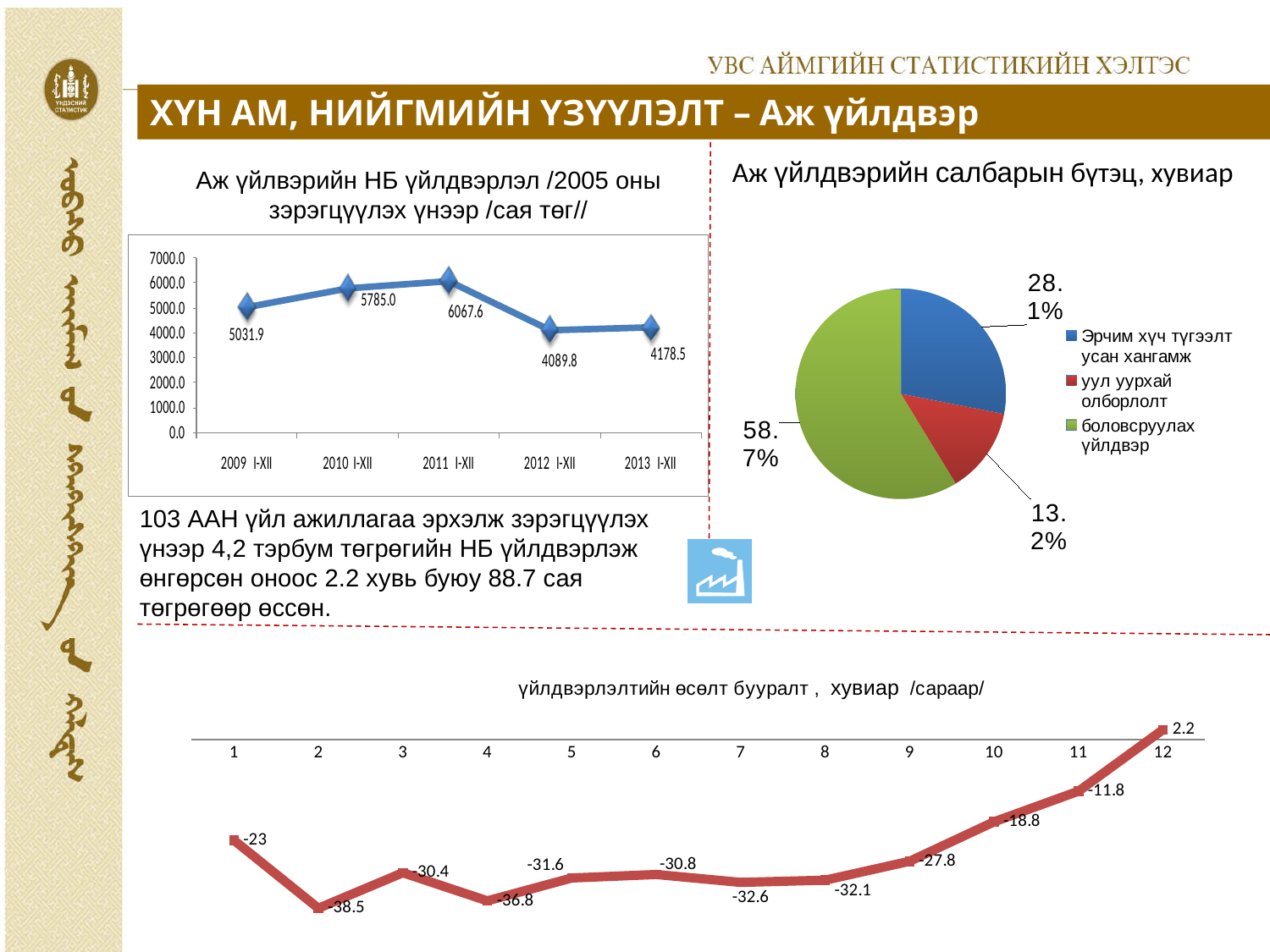
How many entries does the legend of the pie chart 'Аж үйлдвэрийн салбарын бүтэц, хувиар' list? 3 In the top-left chart 'Аж үйлвэрийн НБ үйлдвэрлэл /2005 оны зэрэгцүүлэх үнээр /сая төг//', what is the value for 2011 I-XII? 6067.6 In the bottom chart 'үйлдвэрлэлтийн өсөлт бууралт, хувиар /сараар/', which month has the highest value? 12 In the pie chart 'Аж үйлдвэрийн салбарын бүтэц, хувиар', which sector has the smallest share? уул уурхай олборлолт In the top-left chart 'Аж үйлвэрийн НБ үйлдвэрлэл', which year has the lowest value? 2012 I-XII What type of chart is the bottom chart 'үйлдвэрлэлтийн өсөлт бууралт, хувиар /сараар/'? Line chart In the bottom chart 'үйлдвэрлэлтийн өсөлт бууралт, хувиар /сараар/', what is the value for month 2? -38.5 How many data points are plotted in the top-left chart 'Аж үйлвэрийн НБ үйлдвэрлэл'? 5 In the pie chart 'Аж үйлдвэрийн салбарын бүтэц, хувиар', what colour is the slice for 'Эрчим хүч түгээлт усан хангамж'? Blue In the pie chart 'Аж үйлдвэрийн салбарын бүтэц, хувиар', what share does 'боловсруулах үйлдвэр' have? 58.7% In the top-left chart 'Аж үйлвэрийн НБ үйлдвэрлэл', what is the difference between the 2013 I-XII and 2012 I-XII values? 88.7 In the top-left chart 'Аж үйлвэрийн НБ үйлдвэрлэл', which year has the highest value? 2011 I-XII